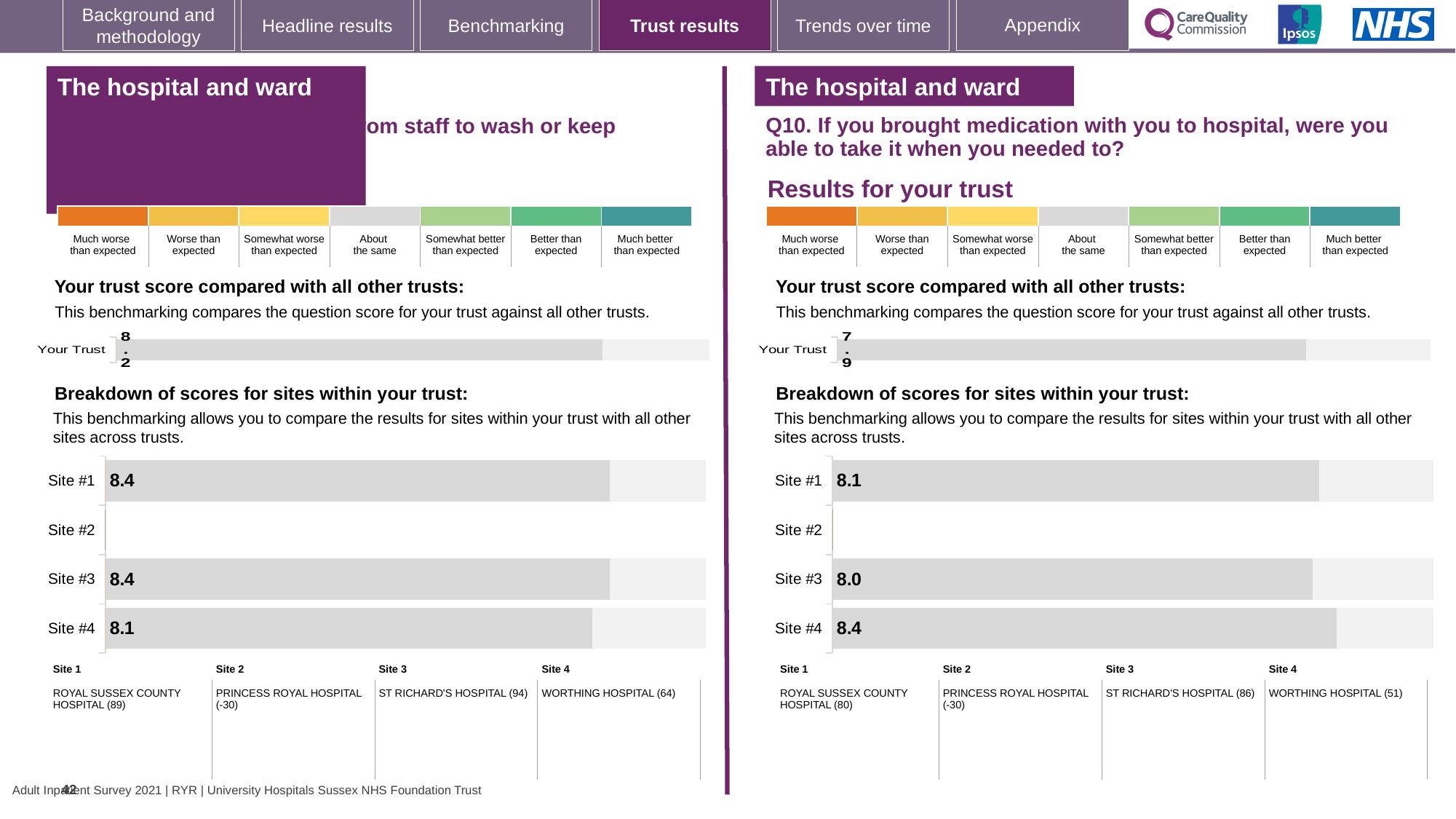
On the right-hand chart (Q10, medication), what is the score for Your Trust? 7.9 How many site rows are shown in the site breakdown chart on the right-hand side? 4 What kind of chart is used for the breakdown of scores for sites on the right-hand side? Bar chart On the left-hand chart, what is the difference between the scores for Site #1 and Site #4? 0.3 On the right-hand chart (Q10), what is the score for Site #1? 8.1 On the right-hand chart (Q10), what is the score for Site #4? 8.4 On the left-hand chart, what is the score for Your Trust? 8.2 On the right-hand chart (Q10), what is the difference between the scores for Site #4 and Site #3? 0.4 On the left-hand chart, what is the score for Site #4? 8.1 On the right-hand chart (Q10), which site has the highest score? Site #4 On the right-hand chart (Q10), which site with a plotted score has the lowest score? Site #3 On the right-hand chart (Q10), which is larger: the score for Site #1 or Site #3? Site #1